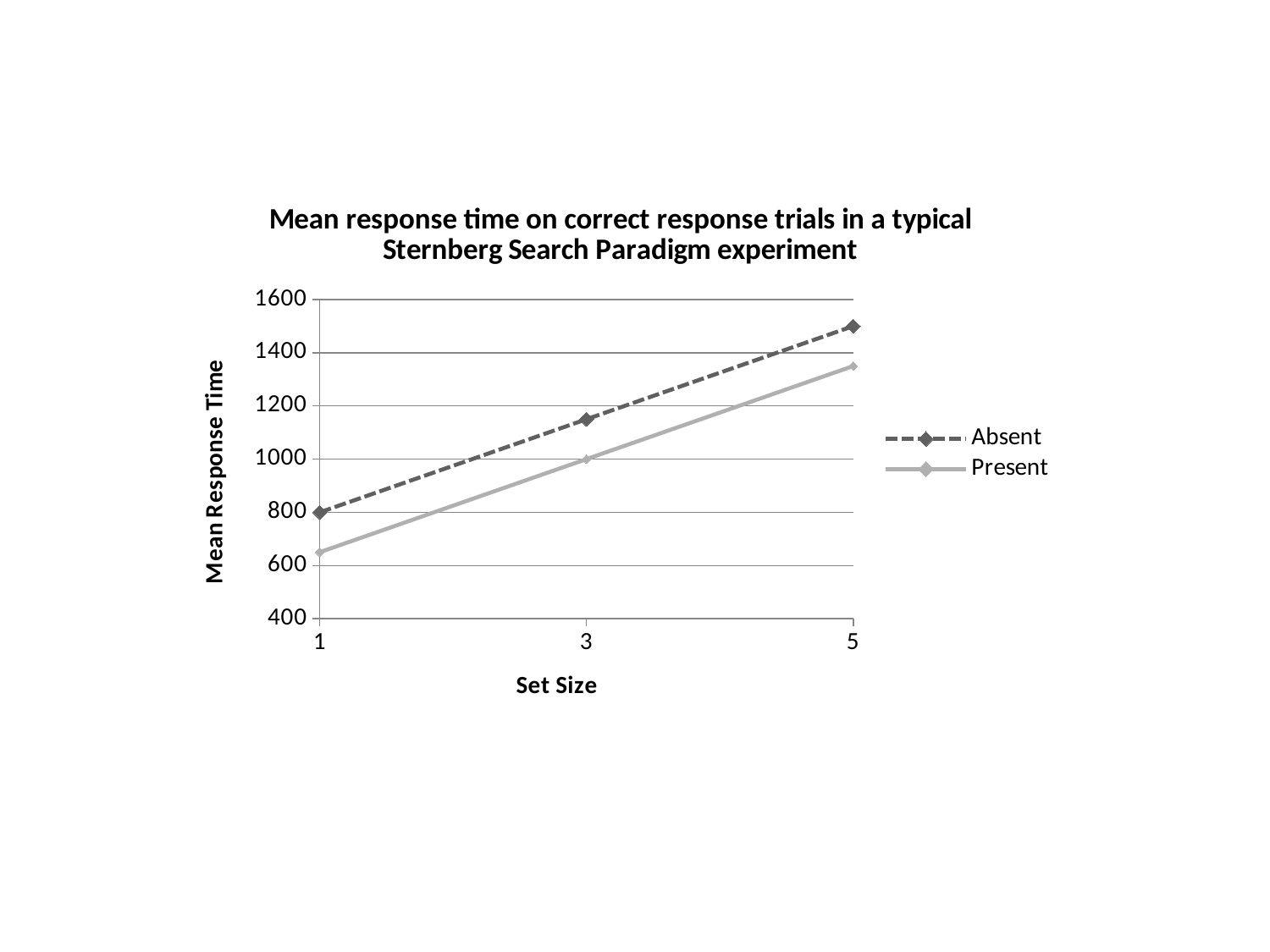
Which series is drawn with a dashed line? Absent Do the mean response times for the Absent series rise or fall as set size increases? rise Is the value for Present at set size 1 greater or less than 800? less Is the value for Present at set size 5 greater or less than 1400? less At set size 5, which series has the higher mean response time, Absent or Present? Absent At which set size is the Present series lowest? 1 How many series does the legend list? 2 What kind of chart is shown on the slide? line chart At which set size is the Absent series highest? 5 Is the value for Absent at set size 3 greater or less than 1000? greater How many set sizes are plotted along the x axis? 3